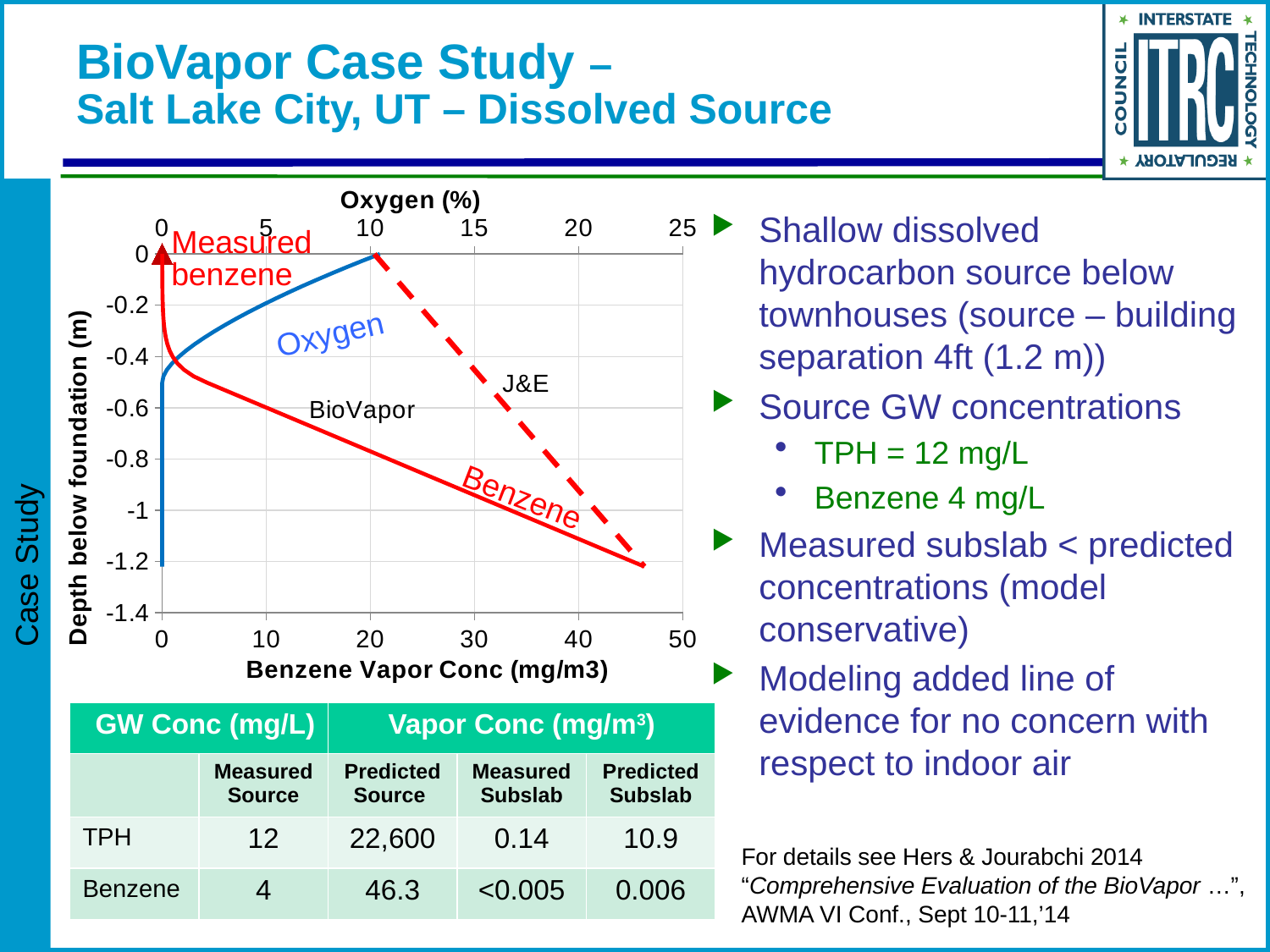
Is the measured benzene vapor concentration at a depth of -0.8 m greater or less than 10 mg/m3? less What is the title of the bottom horizontal axis of the chart? Benzene Vapor Conc (mg/m3) Is the oxygen value at a depth of -0.4 m greater or less than 5%? less What is the maximum value shown on the Oxygen (%) axis? 25 What kind of chart is shown on the slide? line chart Does the BioVapor benzene vapor concentration increase or decrease as depth below the foundation increases? increase Does the oxygen percentage increase or decrease as depth below the foundation increases? decrease What is the title of the vertical axis of the chart? Depth below foundation (m) Is the BioVapor benzene vapor concentration at a depth of -1.2 m greater or less than 40 mg/m3? greater At a depth of -0.8 m, which predicted benzene line shows the higher vapor concentration, J&E or BioVapor? J&E